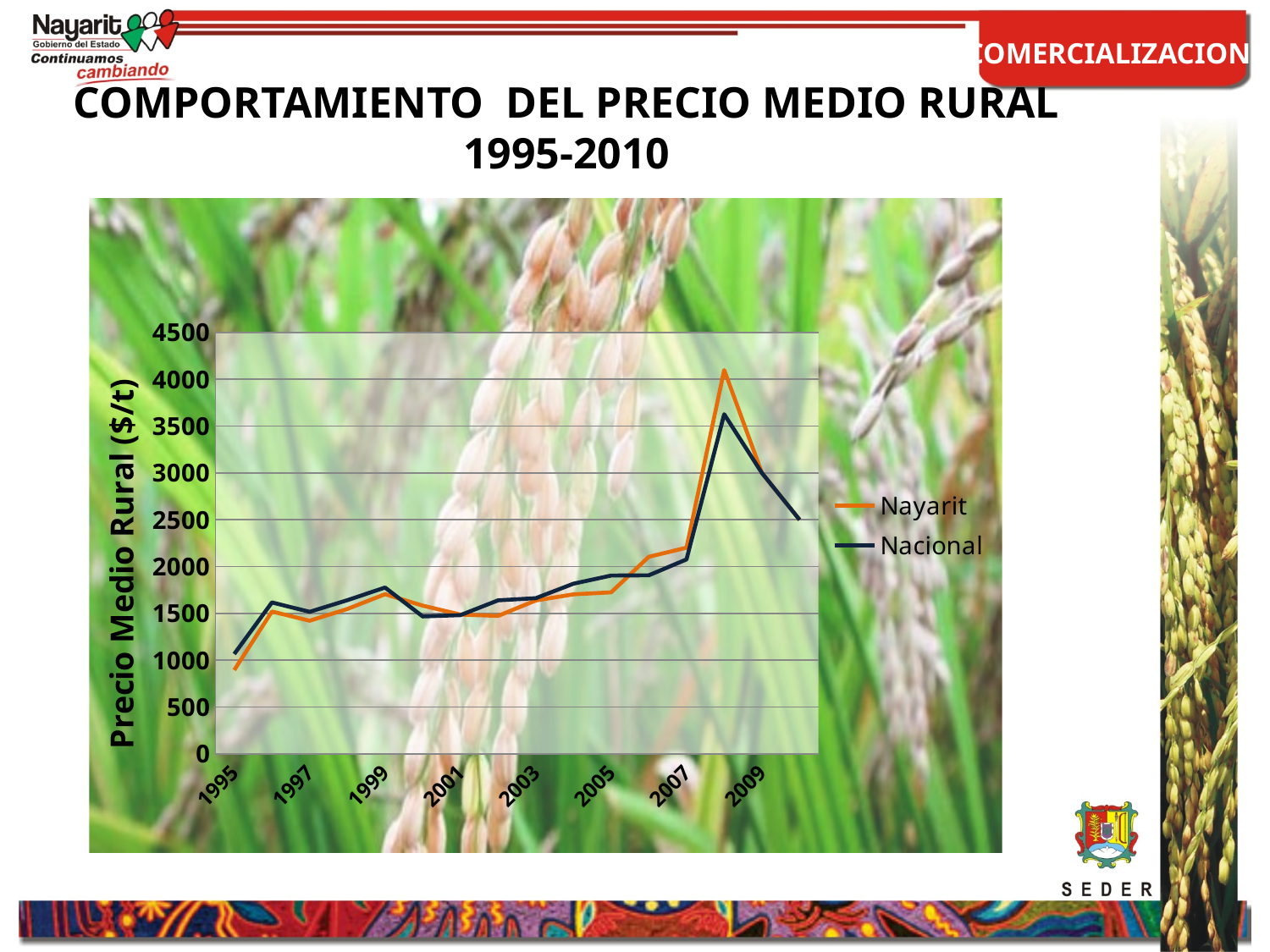
Is the Nacional value in 1995 greater or less than 1000? greater At the 2008 peak, which series has the higher value, Nayarit or Nacional? Nayarit In 1995, which series has the higher value, Nayarit or Nacional? Nacional Is the Nayarit value at its 2008 peak greater or less than 4000? greater In which year does the Nayarit series reach its highest value? 2008 Is the Nacional value at the end of the series (2010) greater or less than 3000? less What is the title of the vertical axis? Precio Medio Rural ($/t) What are the two series named in the legend? Nayarit and Nacional What kind of chart is shown on the slide? line chart How many series does the chart's legend list? 2 Does the Nacional series rise or fall from 2008 to 2010? fall